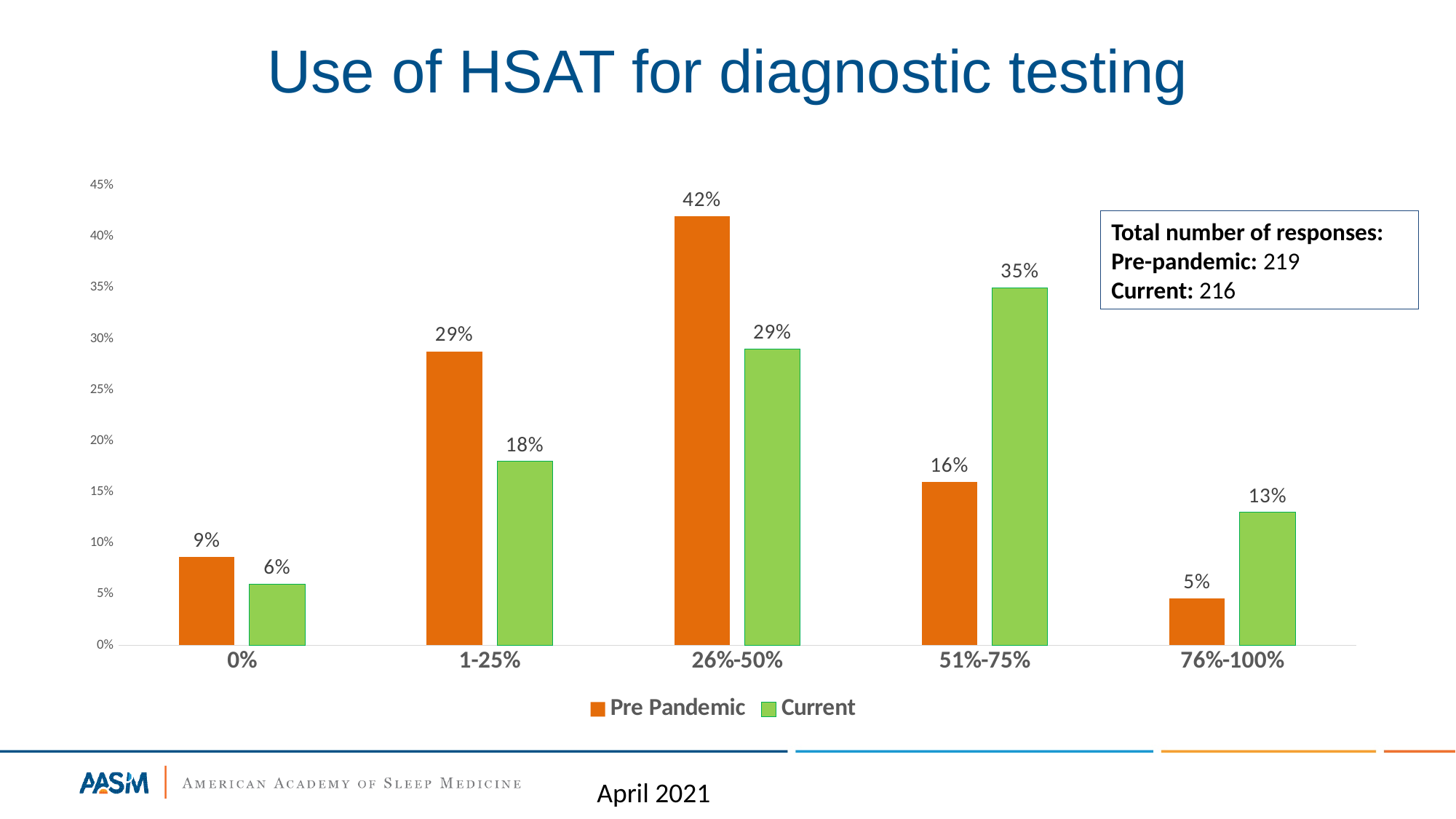
How many series does the legend list? 2 Which category has the highest Pre Pandemic value? 26%-50% What kind of chart is shown on the slide? Bar chart What is the difference between the Pre Pandemic and Current values for the 1-25% category? 11% What colour are the Current bars? Green What is the Current value for the 51%-75% category? 35% What is the Current value for the 0% category? 6% How many categories are shown on the x axis? 5 What is the Pre Pandemic value for the 26%-50% category? 42% Which category has the lowest Current value? 0% For the 76%-100% category, which series has the larger value, Pre Pandemic or Current? Current What is the title of the chart? Use of HSAT for diagnostic testing